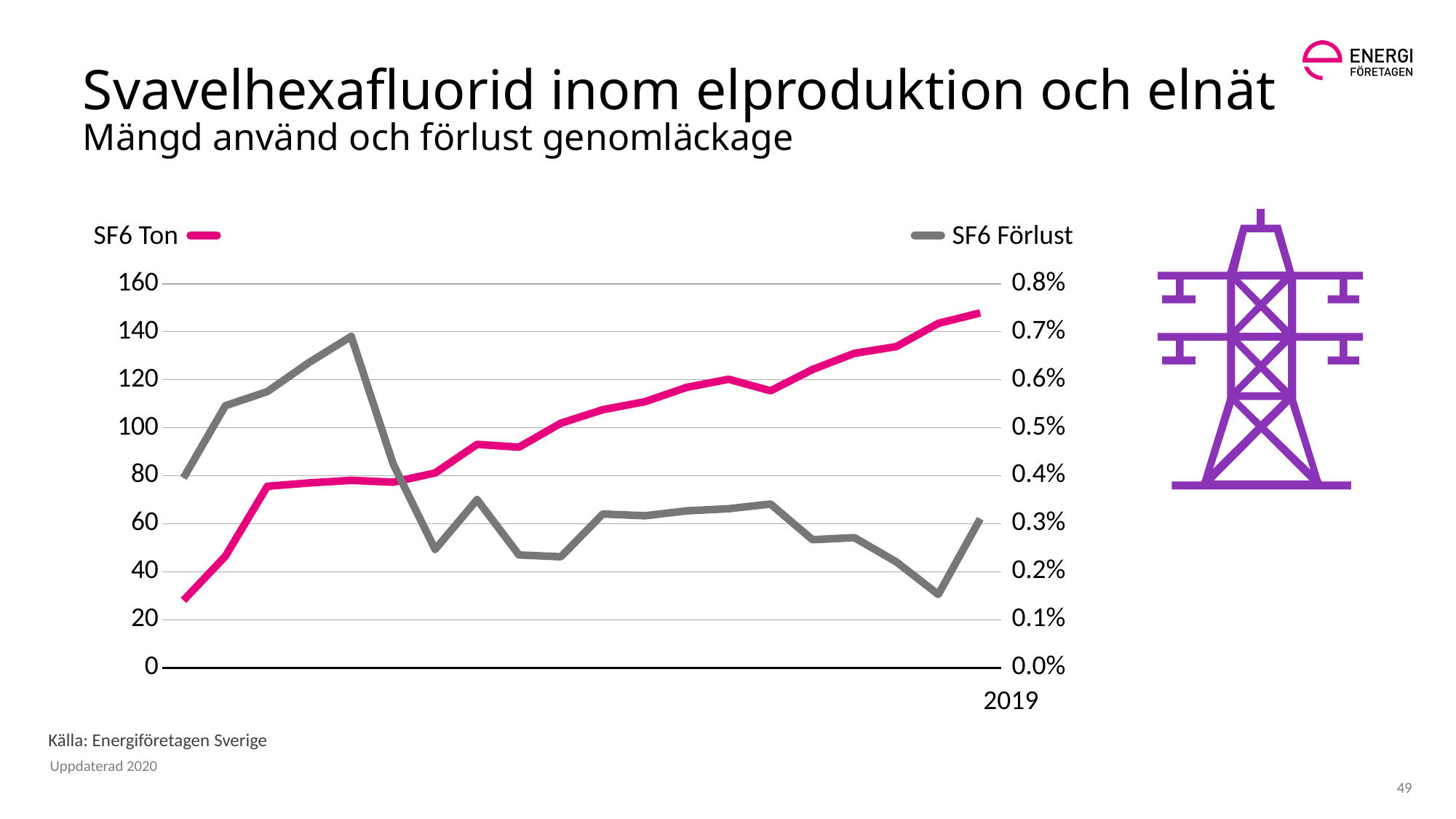
Is the value of SF6 Ton in 2019 greater or less than 140? greater Does the SF6 Ton line generally rise or fall over the period shown? Rise Is the lowest point of the SF6 Förlust line greater or less than 0.2%? less Which colour is the SF6 Ton line? Pink Is the first value of the SF6 Ton line greater or less than 40? less Does the SF6 Förlust line end higher or lower than its early peak? Lower What kind of chart is shown on the slide? Line chart How many series does the chart's legend list? 2 What are the two series named in the legend? SF6 Ton and SF6 Förlust At which point on the x axis does the SF6 Ton line reach its highest value? 2019